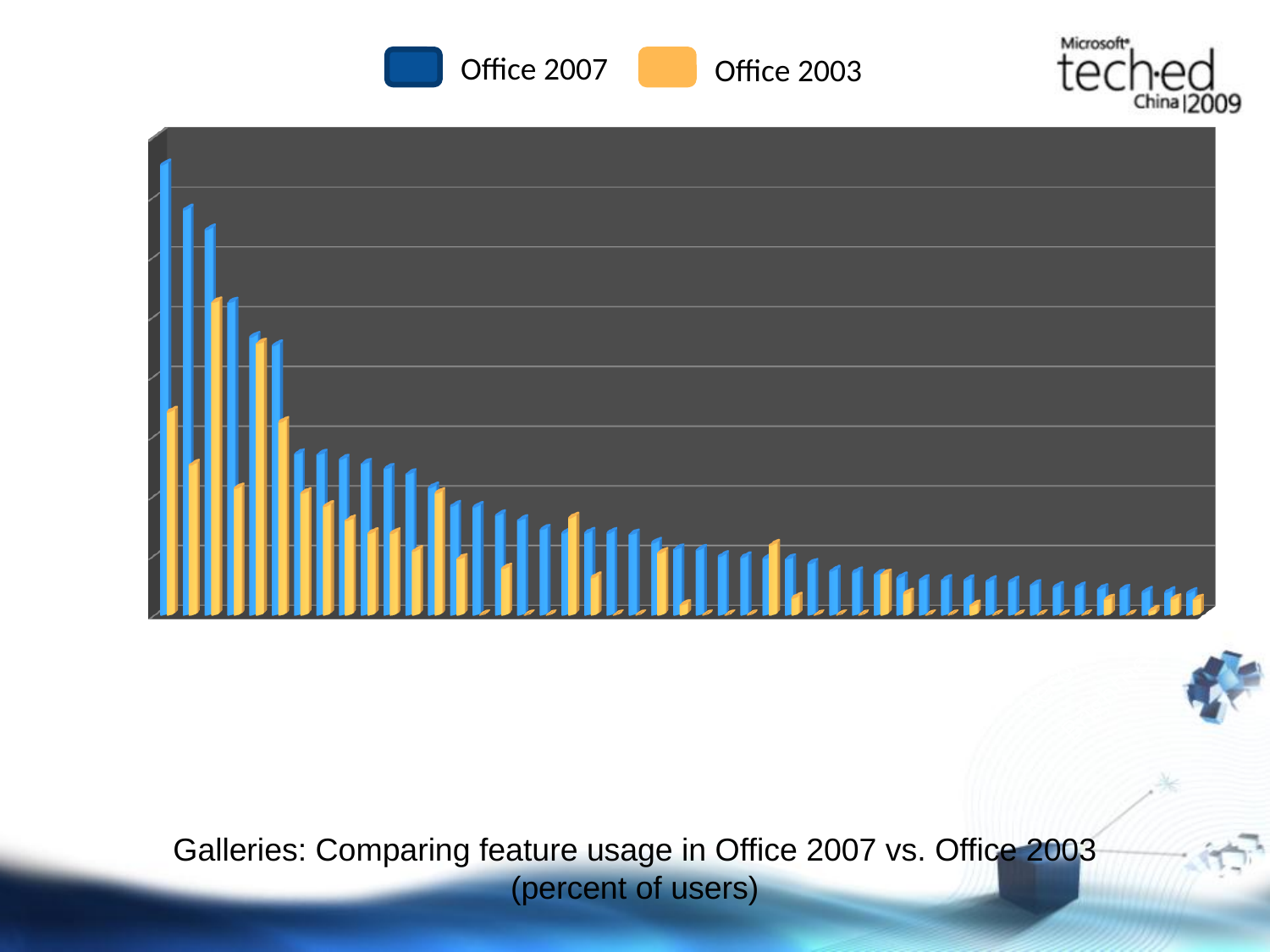
For the leftmost category, which series has the larger value, Office 2007 or Office 2003? Office 2007 Which two series are listed in the chart's legend? Office 2007 and Office 2003 Do the Office 2007 values rise or fall moving from left to right along the x axis? fall For the second category from the left, which series has the larger value, Office 2007 or Office 2003? Office 2007 What kind of chart is shown on the slide? bar chart Which series has the tallest bar in the chart? Office 2007 What is the caption of the chart? Galleries: Comparing feature usage in Office 2007 vs. Office 2003 (percent of users) How many series does the chart's legend list? 2